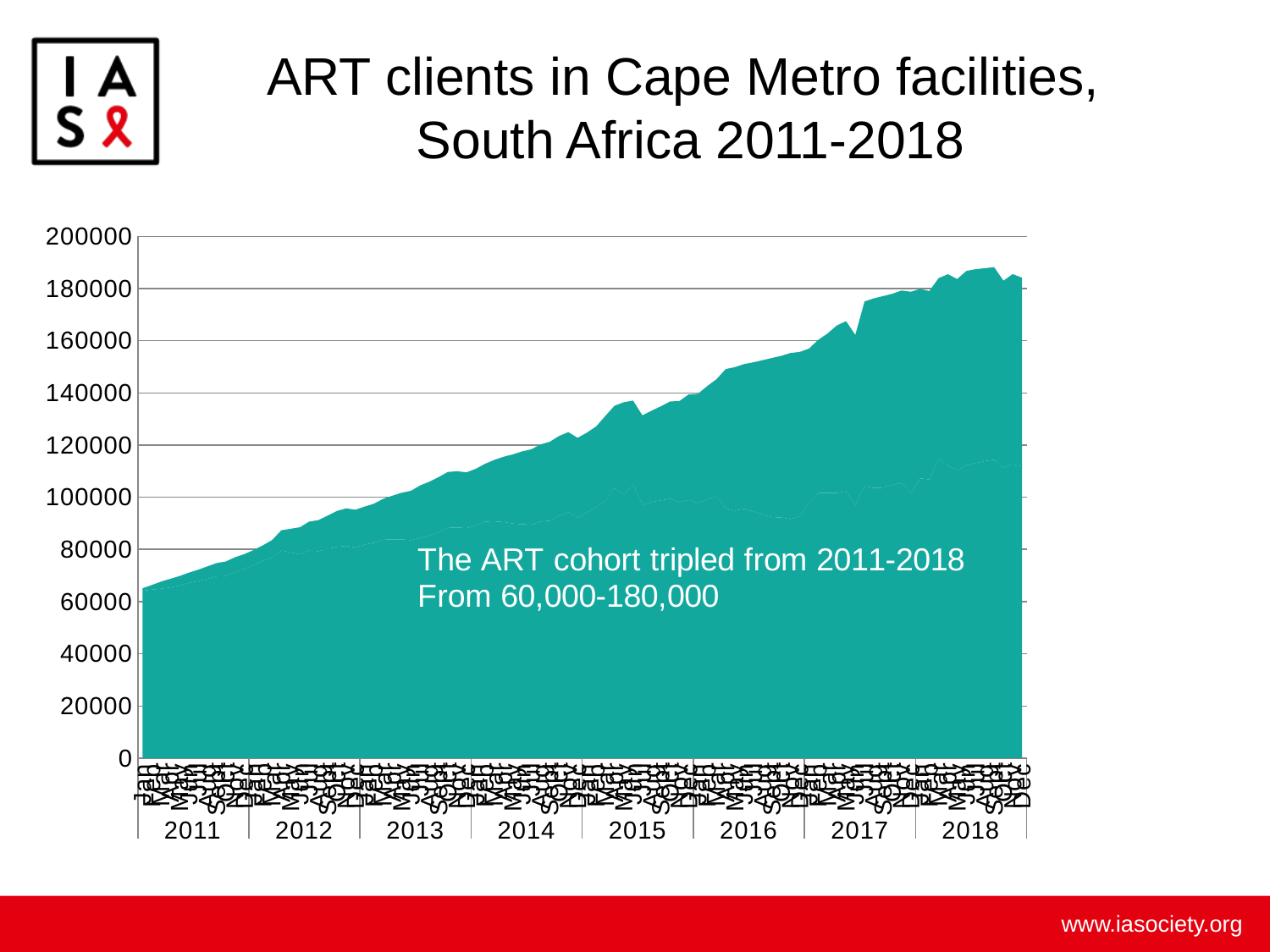
In which year is the number of ART clients lowest? 2011 Is the value at the start of 2011 greater or less than 80000? less What is the highest tick value shown on the y axis? 200000 Is the value at the start of 2014 greater or less than 100000? greater How many years are labelled on the x axis? 8 Do the values rise or fall from 2011 to 2018? rise In which year is the number of ART clients highest? 2018 What kind of chart is shown on the slide? area chart What is the title of the chart? ART clients in Cape Metro facilities, South Africa 2011-2018 Is the value at the start of 2011 greater or less than 60000? greater Which year has the larger number of ART clients, 2013 or 2017? 2017